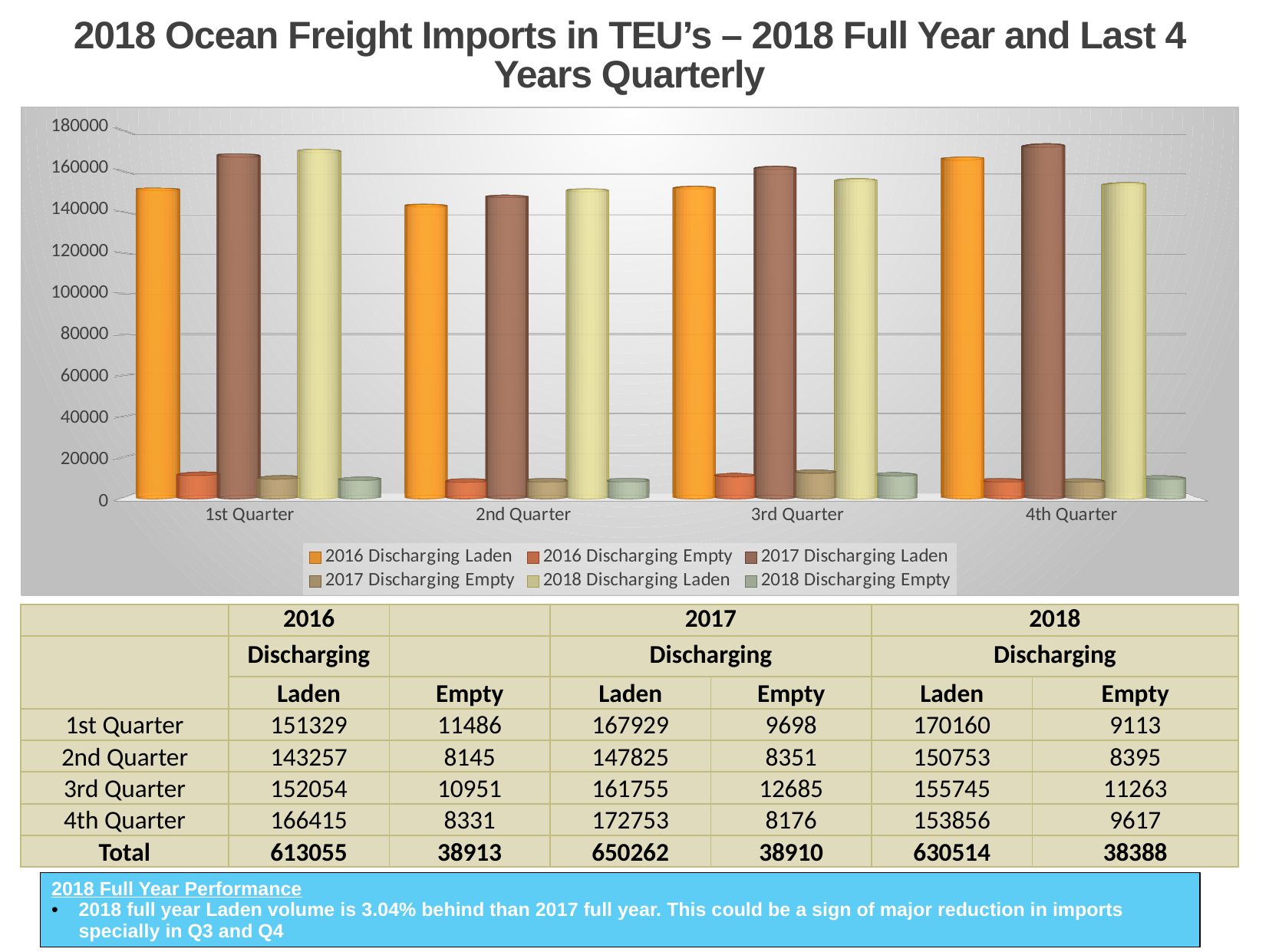
What type of chart is shown on the slide? bar chart Is the 2016 Discharging Laden value for the 2nd Quarter greater or less than 160000? less What is the 2018 Discharging Empty value for the 3rd Quarter? 11263 In which quarter is the 2017 Discharging Laden value highest? 4th Quarter Which is larger in the 3rd Quarter: 2017 Discharging Laden or 2018 Discharging Laden? 2017 Discharging Laden What is the difference between the 2017 Discharging Laden and 2016 Discharging Laden values in the 4th Quarter? 6338 In which quarter is the 2016 Discharging Laden value lowest? 2nd Quarter How many quarters are shown on the x axis of the chart? 4 What is the 2017 Discharging Laden value for the 4th Quarter? 172753 Which series is shown in orange in the chart? 2016 Discharging Laden Does the 2017 Discharging Laden value rise or fall from the 3rd Quarter to the 4th Quarter? rise How many series does the chart legend list? 6